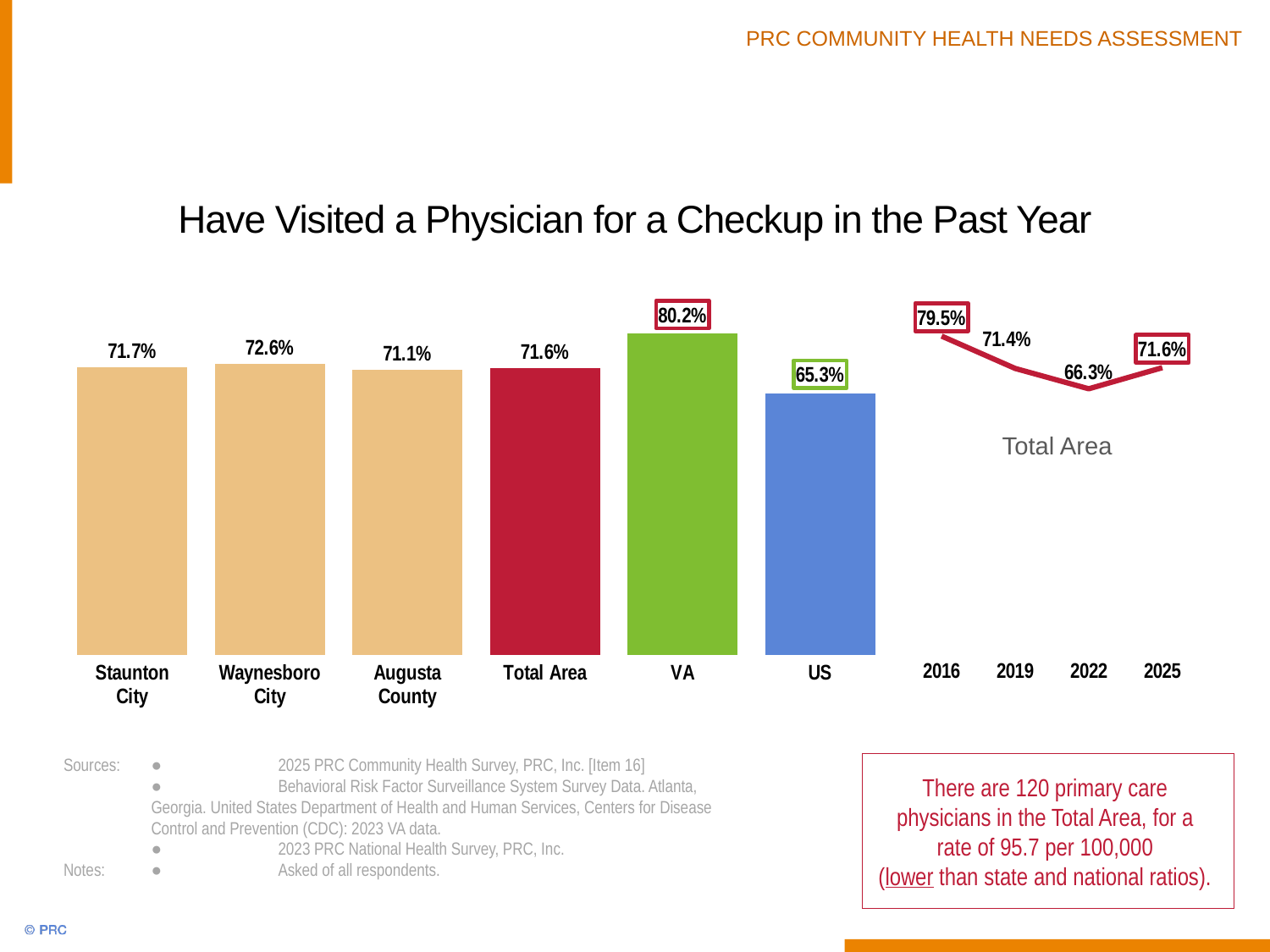
In the bar chart, what is the value for Waynesboro City? 72.6% How many categories are shown in the bar chart? 6 In the bar chart, what is the difference between the VA value and the Total Area value? 8.6% What kind of chart is the chart on the left side of the slide? Bar chart In the Total Area line chart, which year has the highest value? 2016 In the bar chart, which category has the highest value? VA In the bar chart, what is the value for the US? 65.3% In the bar chart, which category has the lowest value? US In the Total Area line chart, do the values rise or fall from 2016 to 2022? Fall In the bar chart, which is larger, the value for Staunton City or the value for Augusta County? Staunton City In the Total Area line chart, what is the value for 2022? 66.3% In the Total Area line chart, what is the difference between the 2016 value and the 2025 value? 7.9%